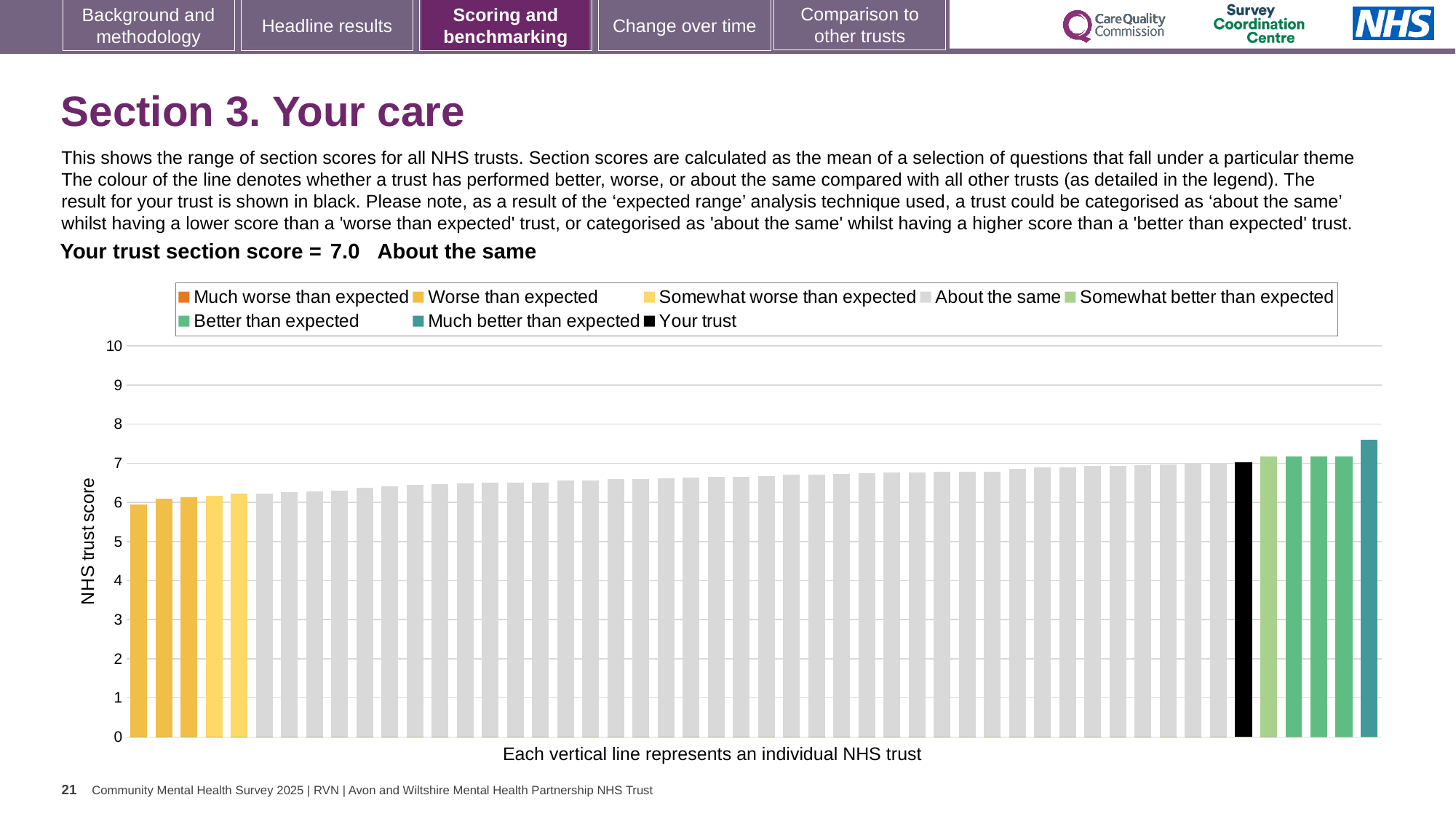
What is the section score for your trust shown on the slide? 7.0 How many entries does the chart legend list? 8 What colour is the bar representing your trust? black How many bars are coloured as 'Much better than expected'? 1 Is the value of the tallest bar greater or less than 7? greater Is the value of the shortest bar greater or less than 7? less Which category is your trust placed in for this section? About the same What is the label on the vertical axis? NHS trust score What kind of chart is shown on the slide? bar chart How many bars are coloured as 'Much worse than expected'? 0 Do the bar values rise or fall from left to right along the x axis? rise Is the value of the tallest bar greater or less than 8? less